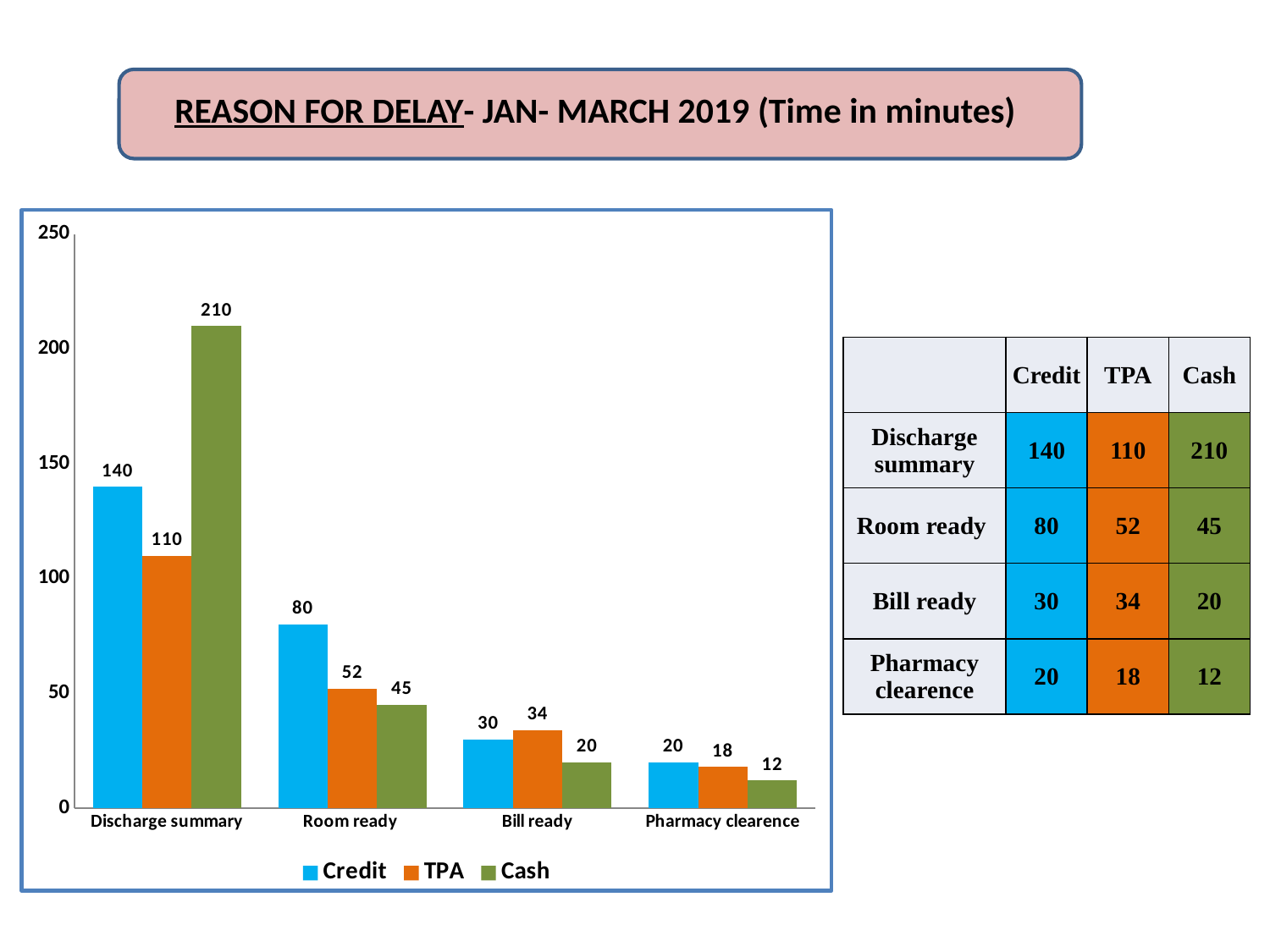
What is the difference between the Cash and Credit values for Discharge summary? 70 For Bill ready, which is larger: the Credit value or the TPA value? TPA Do the Credit values rise or fall from Discharge summary to Pharmacy clearence? fall What kind of chart is shown on the slide? bar chart Which category has the highest Credit value? Discharge summary What is the Credit value for Pharmacy clearence? 20 Which category has the lowest Cash value? Pharmacy clearence How many series does the legend list? 3 How many categories are shown on the x axis? 4 What is the TPA value for Room ready? 52 Is the TPA value for Discharge summary greater or less than 100? greater What is the Cash value for Discharge summary? 210